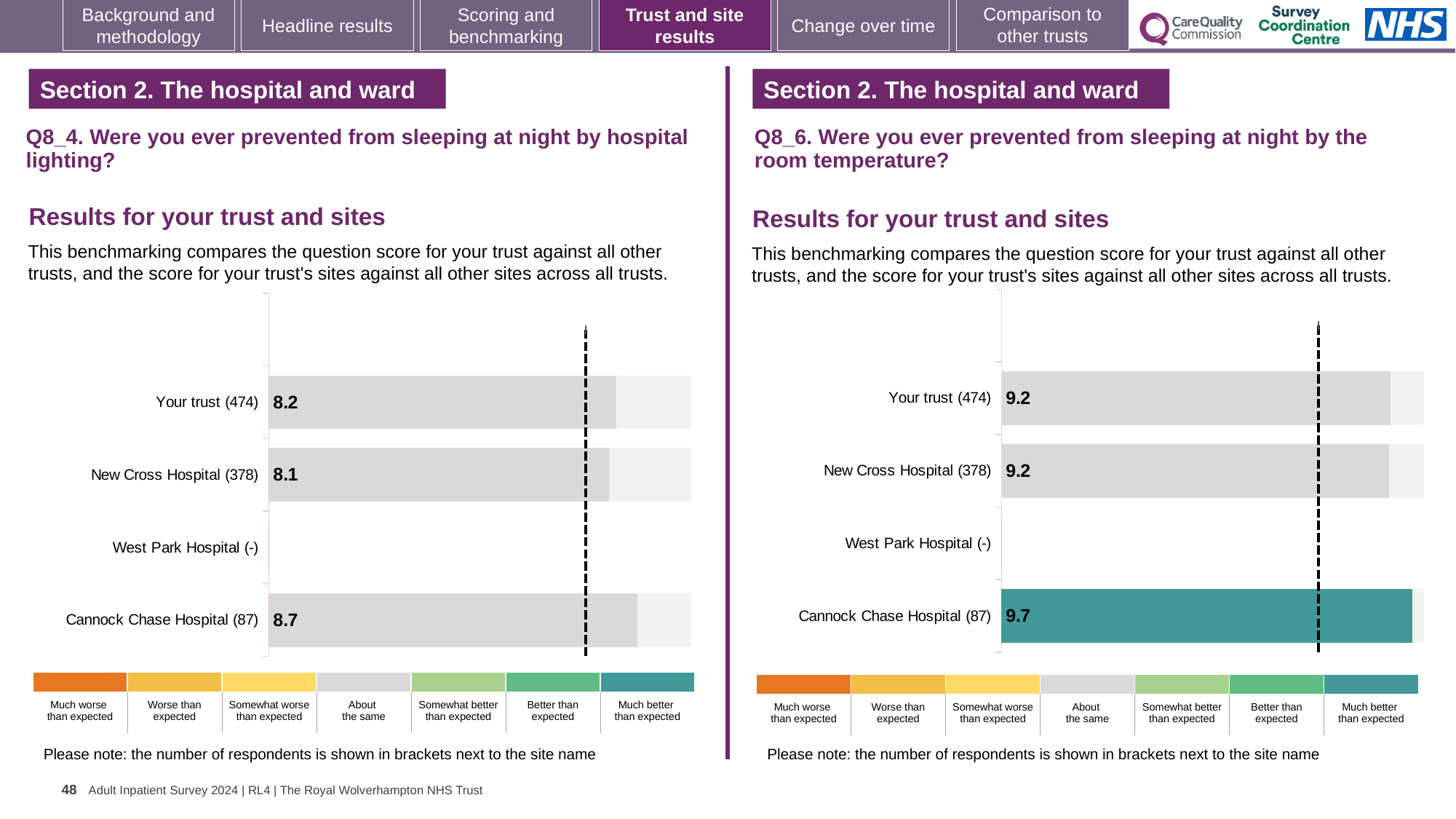
In the Q8_6 chart (room temperature), what is the score for New Cross Hospital (378)? 9.2 In the Q8_4 chart (hospital lighting), what is the score for Cannock Chase Hospital (87)? 8.7 In the Q8_4 chart (hospital lighting), what is the difference between the scores for Cannock Chase Hospital (87) and New Cross Hospital (378)? 0.6 In the Q8_4 chart (hospital lighting), which is larger: the score for Your trust (474) or New Cross Hospital (378)? Your trust (474) In the Q8_6 chart (room temperature), which site has the highest score? Cannock Chase Hospital (87) In the Q8_4 chart (hospital lighting), which site has the highest score? Cannock Chase Hospital (87) In the Q8_6 chart (room temperature), which benchmark category does the colour of the Cannock Chase Hospital (87) bar correspond to? Much better than expected In the Q8_4 chart (hospital lighting), what is the score for Your trust (474)? 8.2 What type of chart is used in the Q8_4 chart (hospital lighting)? Bar chart In the Q8_6 chart (room temperature), what is the difference between the scores for Cannock Chase Hospital (87) and Your trust (474)? 0.5 In the Q8_6 chart (room temperature), how many site/trust categories are listed on the axis? 4 In the Q8_6 chart (room temperature), what is the score for Cannock Chase Hospital (87)? 9.7